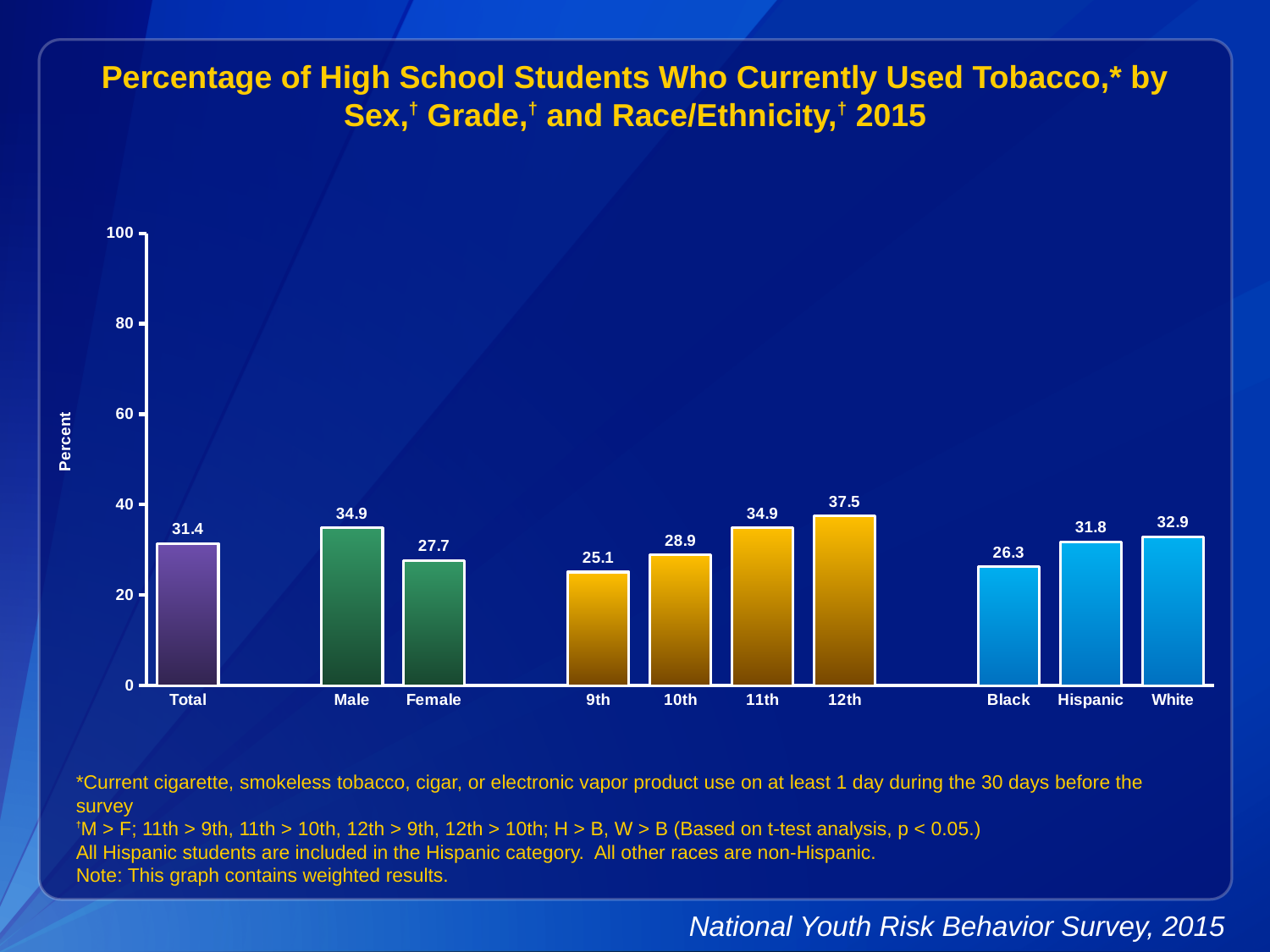
What is the difference between the values for Male and Female? 7.2 Which category has the lowest value? 9th What is the difference between the values for White and Black? 6.6 Which category has the highest value? 12th Which is larger, the value for 10th grade or the value for 11th grade? 11th What kind of chart is shown on the slide? Bar chart How many bars are shown in the chart? 10 What is the value for Hispanic? 31.8 Do the values rise or fall from 9th grade to 12th grade? Rise What is the value for Female? 27.7 What is the value for Total? 31.4 What is the value for 12th grade? 37.5